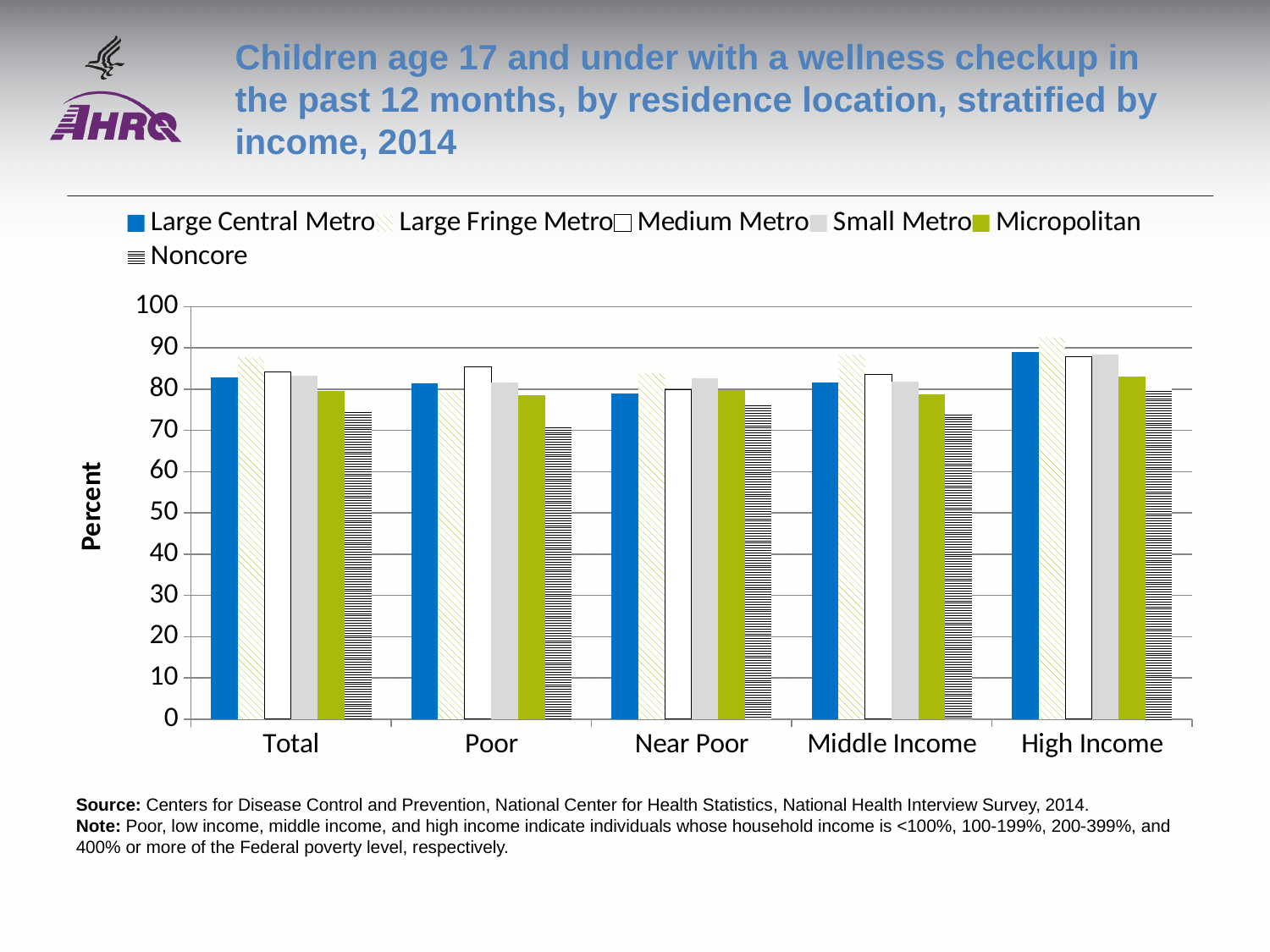
Is the Noncore value larger for the Poor group or the High Income group? High Income Within the High Income group, which residence location has the highest value? Large Fringe Metro Is the Noncore value for the Poor group greater or less than 80? less What kind of chart is shown on the slide? Bar chart What is the label on the y axis? Percent Which income group has the highest Large Central Metro value? High Income Is the Noncore value for the Near Poor group greater or less than 80? less How many series does the legend list? 6 Within the Poor group, which residence location has the lowest value? Noncore Is the Large Central Metro value for the Total group greater or less than 80? greater How many income categories are shown on the x axis? 5